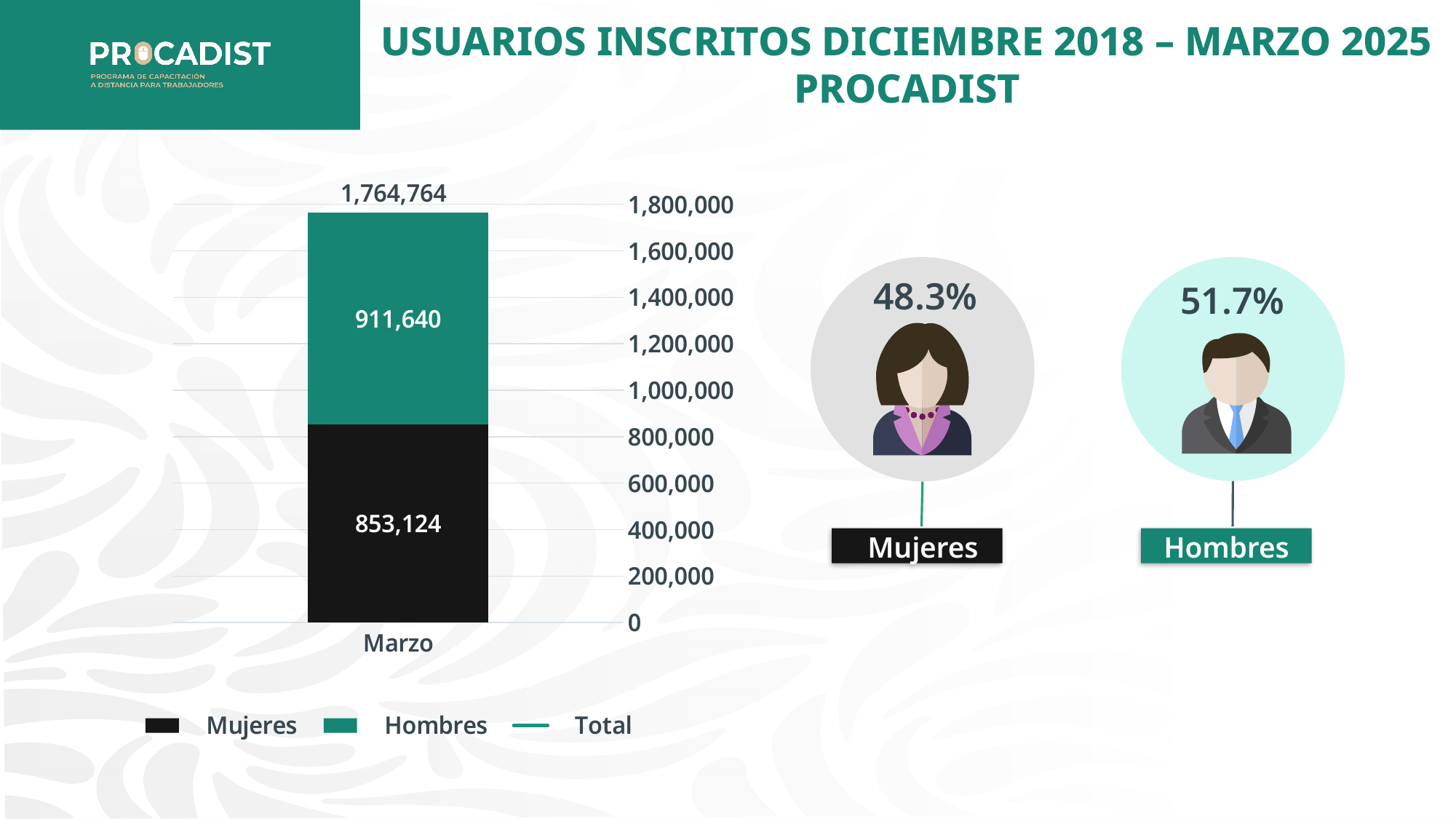
Which colour represents Hombres in the chart? Teal (green) What kind of chart is shown on the slide? Stacked bar chart What is the label of the category on the x axis? Marzo What is the total shown above the Marzo stacked bar? 1,764,764 How many categories are shown on the x axis of the chart? 1 Is the total of the Marzo bar greater or less than 1,600,000? greater What is the value for Mujeres in the Marzo bar? 853,124 Which series has the larger value in the Marzo bar, Mujeres or Hombres? Hombres What is the value for Hombres in the Marzo bar? 911,640 How many entries does the chart legend list? 3 What is the difference between the Hombres value and the Mujeres value in the Marzo bar? 58,516 Is the value for Mujeres greater or less than 1,000,000? less